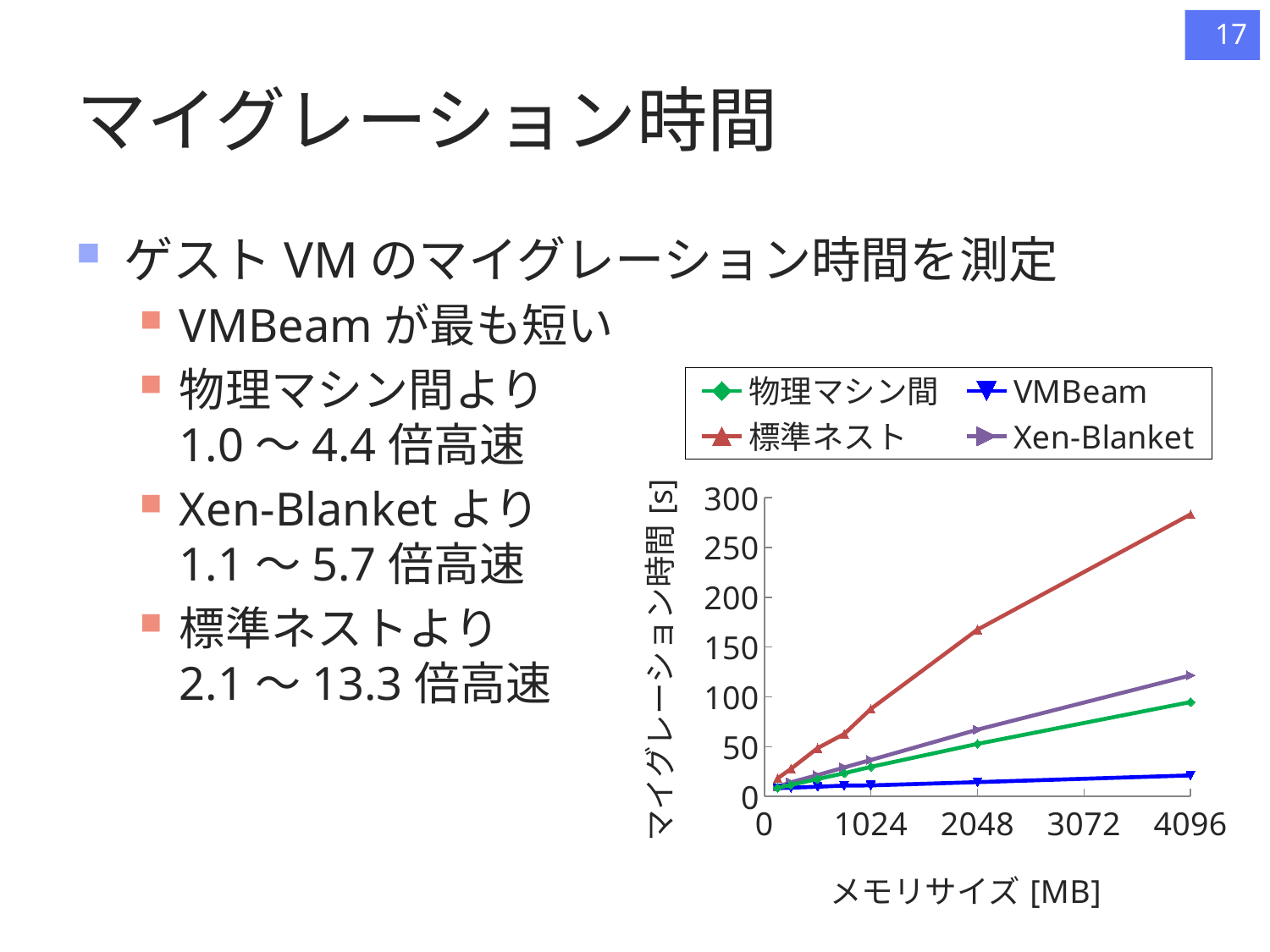
What is the label of the x axis of the chart? メモリサイズ [MB] Is the migration time for 標準ネスト at 4096 MB greater or less than 250? greater Does the migration time for 標準ネスト rise or fall as memory size increases? rise What kind of chart is shown on the slide? line chart At 4096 MB, which has the larger migration time: Xen-Blanket or 物理マシン間? Xen-Blanket Is the migration time for 物理マシン間 at 2048 MB greater or less than 100? less Is the migration time for Xen-Blanket at 4096 MB greater or less than 100? greater Which series has the highest migration time at a memory size of 4096 MB? 標準ネスト How many series does the legend of the chart list? 4 Which series has the lowest migration time at a memory size of 4096 MB? VMBeam